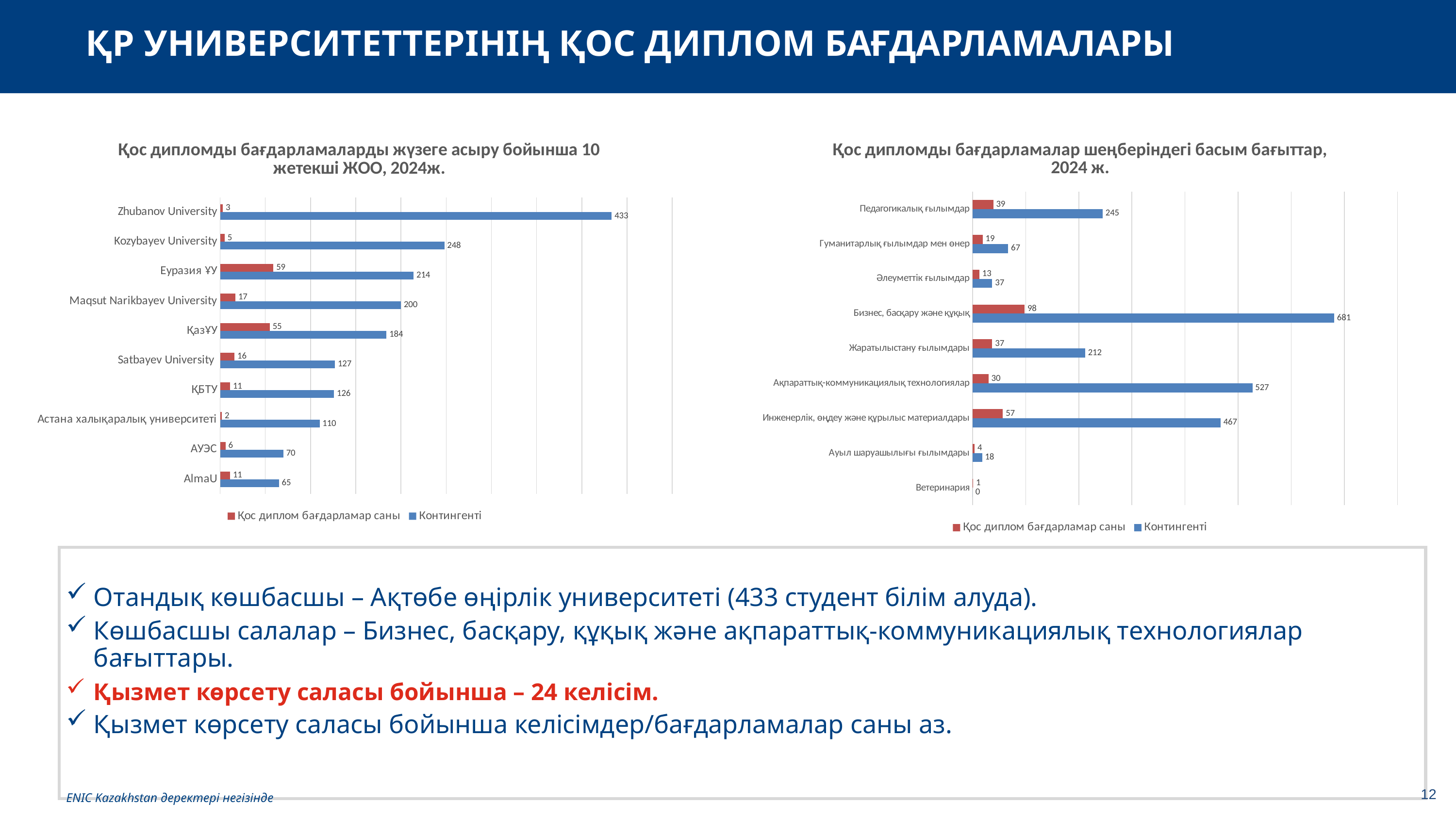
In the left chart (10 жетекші ЖОО, 2024ж.), what is the Контингенті value for Zhubanov University? 433 In the left chart (10 жетекші ЖОО, 2024ж.), which university has the lowest Контингенті value? AlmaU In the left chart (10 жетекші ЖОО, 2024ж.), what is the difference between the Контингенті values of Kozybayev University and Еуразия ҰУ? 34 In the right chart (басым бағыттар, 2024 ж.), what is the Контингенті value for Бизнес, басқару және құқық? 681 In the right chart (басым бағыттар, 2024 ж.), what is the Қос диплом бағдарламар саны value for Инженерлік, өңдеу және құрылыс материалдары? 57 In the left chart (10 жетекші ЖОО, 2024ж.), how many universities are shown? 10 In the right chart (басым бағыттар, 2024 ж.), which direction has the highest Қос диплом бағдарламар саны value? Бизнес, басқару және құқық What type of chart is the left chart (10 жетекші ЖОО, 2024ж.)? Bar chart In the right chart (басым бағыттар, 2024 ж.), how many series does the legend list? 2 In the left chart (10 жетекші ЖОО, 2024ж.), what is the Қос диплом бағдарламар саны value for Еуразия ҰУ? 59 In the right chart (басым бағыттар, 2024 ж.), which is larger: the Контингенті value for Ақпараттық-коммуникациялық технологиялар or for Инженерлік, өңдеу және құрылыс материалдары? Ақпараттық-коммуникациялық технологиялар In the left chart (10 жетекші ЖОО, 2024ж.), which university has the highest Контингенті value? Zhubanov University